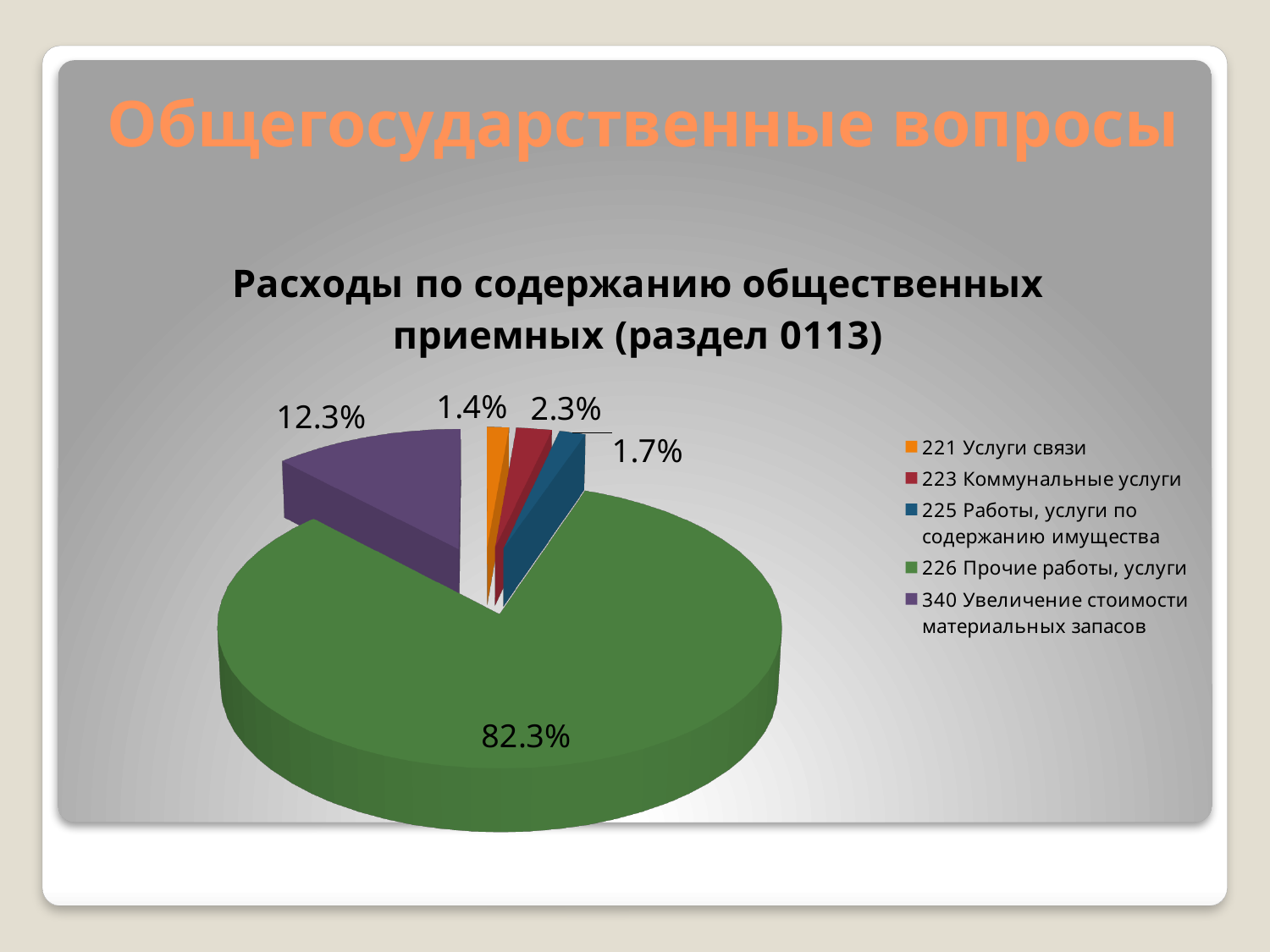
What share of the pie is '226 Прочие работы, услуги'? 82.3% What share of the pie is '340 Увеличение стоимости материальных запасов'? 12.3% Which category has the largest share of the pie? 226 Прочие работы, услуги What share of the pie is '225 Работы, услуги по содержанию имущества'? 1.7% How many slices does the pie chart have? 5 Which category has the smallest share of the pie? 221 Услуги связи Which is larger: the share for '223 Коммунальные услуги' or for '225 Работы, услуги по содержанию имущества'? 223 Коммунальные услуги What is the difference in percentage points between '226 Прочие работы, услуги' and '340 Увеличение стоимости материальных запасов'? 70 percentage points What is the title of the chart? Расходы по содержанию общественных приемных (раздел 0113) What kind of chart is shown on the slide? Pie chart